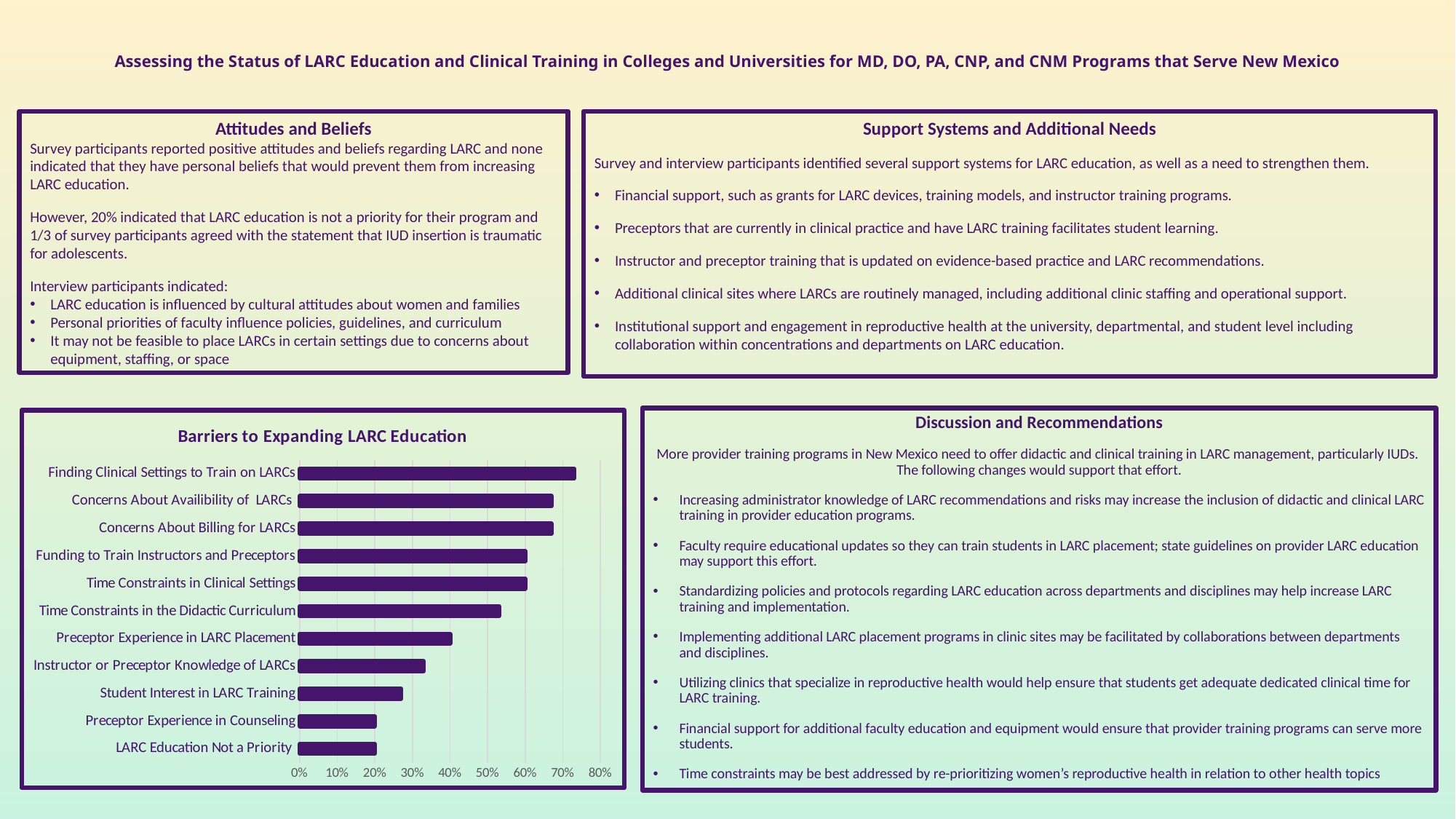
In the "Barriers to Expanding LARC Education" chart, which is larger: Time Constraints in the Didactic Curriculum or Preceptor Experience in LARC Placement? Time Constraints in the Didactic Curriculum What is the highest value shown on the horizontal axis of the "Barriers to Expanding LARC Education" chart? 80% What is the title of the chart on the slide? Barriers to Expanding LARC Education In the "Barriers to Expanding LARC Education" chart, is the value for Student Interest in LARC Training greater or less than 30%? less How many barriers (categories) are plotted in the "Barriers to Expanding LARC Education" chart? 11 In the "Barriers to Expanding LARC Education" chart, which is larger: Finding Clinical Settings to Train on LARCs or Student Interest in LARC Training? Finding Clinical Settings to Train on LARCs In the "Barriers to Expanding LARC Education" chart, which barrier has the highest value? Finding Clinical Settings to Train on LARCs What type of chart is shown under the title "Barriers to Expanding LARC Education"? Bar chart In the "Barriers to Expanding LARC Education" chart, is the value for Time Constraints in the Didactic Curriculum greater or less than 50%? greater In the "Barriers to Expanding LARC Education" chart, is the value for Finding Clinical Settings to Train on LARCs greater or less than 70%? greater